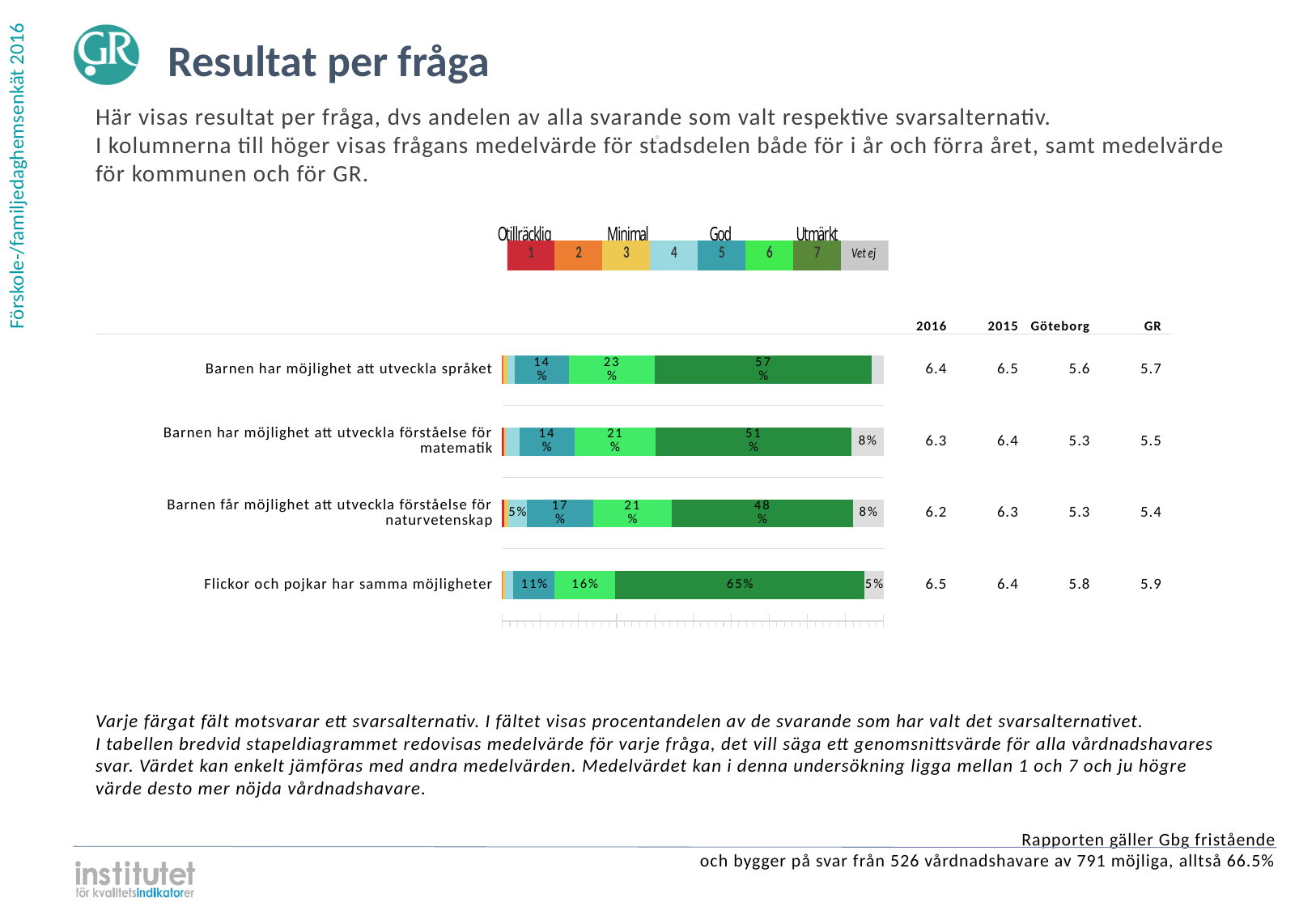
What is the title of the slide containing the chart? Resultat per fråga What is the difference in percentage points between the option 7 share for 'Flickor och pojkar har samma möjligheter' and for 'Barnen får möjlighet att utveckla förståelse för naturvetenskap'? 17 percentage points How many response options does the legend above the chart list? 8 What percentage of respondents chose option 7 (dark green) for 'Barnen har möjlighet att utveckla språket'? 57% Which has a larger option 6 (light green) share: 'Barnen har möjlighet att utveckla språket' or 'Flickor och pojkar har samma möjligheter'? Barnen har möjlighet att utveckla språket Which question has the smallest share of option 7 (dark green) responses? Barnen får möjlighet att utveckla förståelse för naturvetenskap What is the 'Vet ej' share for 'Barnen har möjlighet att utveckla förståelse för matematik'? 8% What percentage of respondents chose option 7 (dark green) for 'Flickor och pojkar har samma möjligheter'? 65% What percentage of respondents chose option 5 (teal) for 'Barnen får möjlighet att utveckla förståelse för naturvetenskap'? 17% Which question has the largest share of option 7 (dark green) responses? Flickor och pojkar har samma möjligheter How many questions (categories) are plotted in the bar chart? 4 What kind of chart is shown on the slide? Stacked bar chart